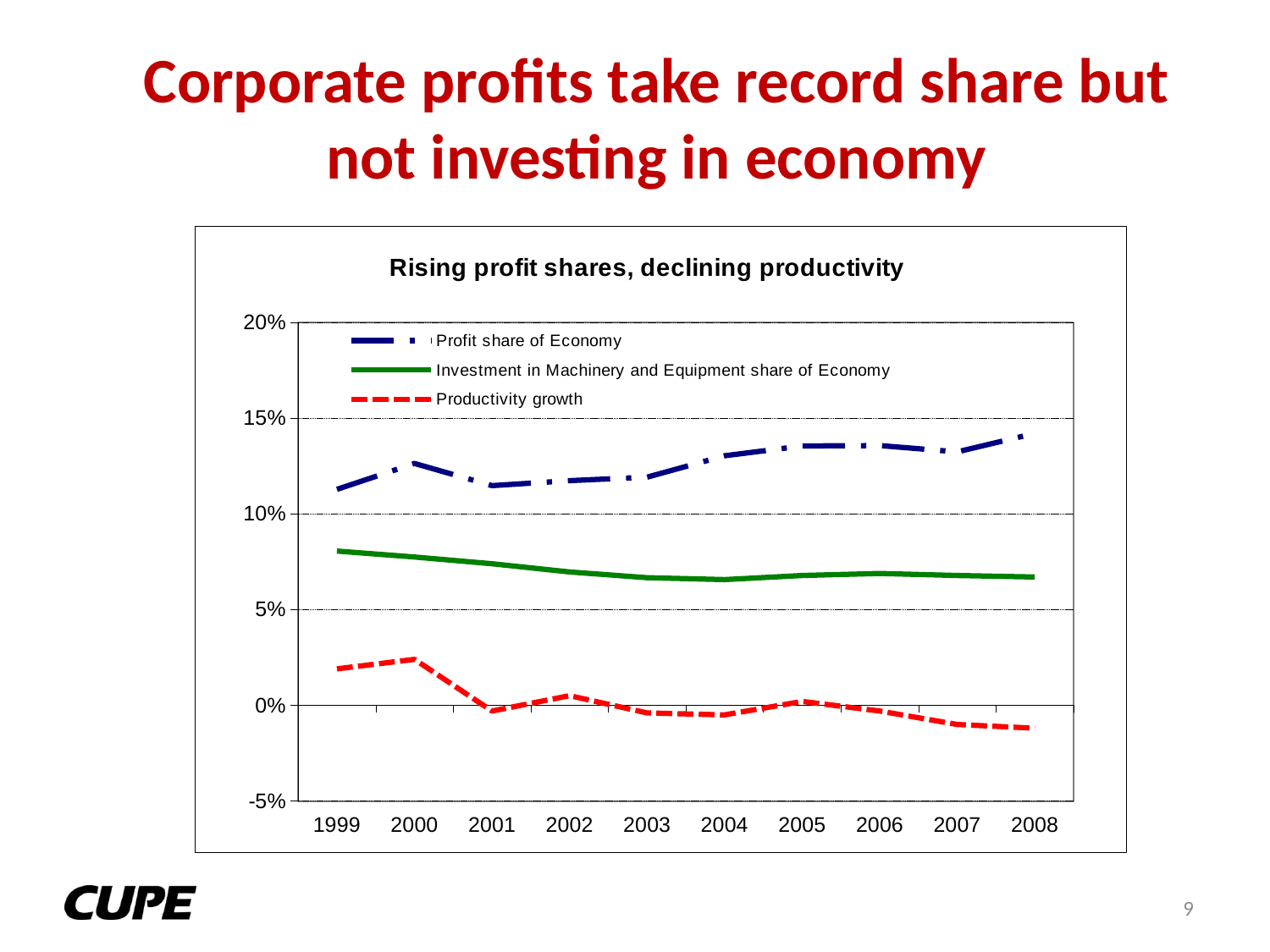
Is the Profit share of Economy value for 2008 greater or less than 10%? greater What kind of chart is shown on the slide? line chart Is the Investment in Machinery and Equipment share of Economy value for 1999 greater or less than 10%? less Which series is drawn as a red dashed line in the chart? Productivity growth Is the Productivity growth value for 2008 greater or less than 0%? less How many series does the chart's legend list? 3 In 2008, which is larger: Profit share of Economy or Investment in Machinery and Equipment share of Economy? Profit share of Economy How many years are shown along the x axis of the chart? 10 What is the title of the chart? Rising profit shares, declining productivity Does the Profit share of Economy line generally rise or fall from 1999 to 2008? rise In which year is Productivity growth at its highest? 2000 Does the Productivity growth line generally rise or fall from 1999 to 2008? fall